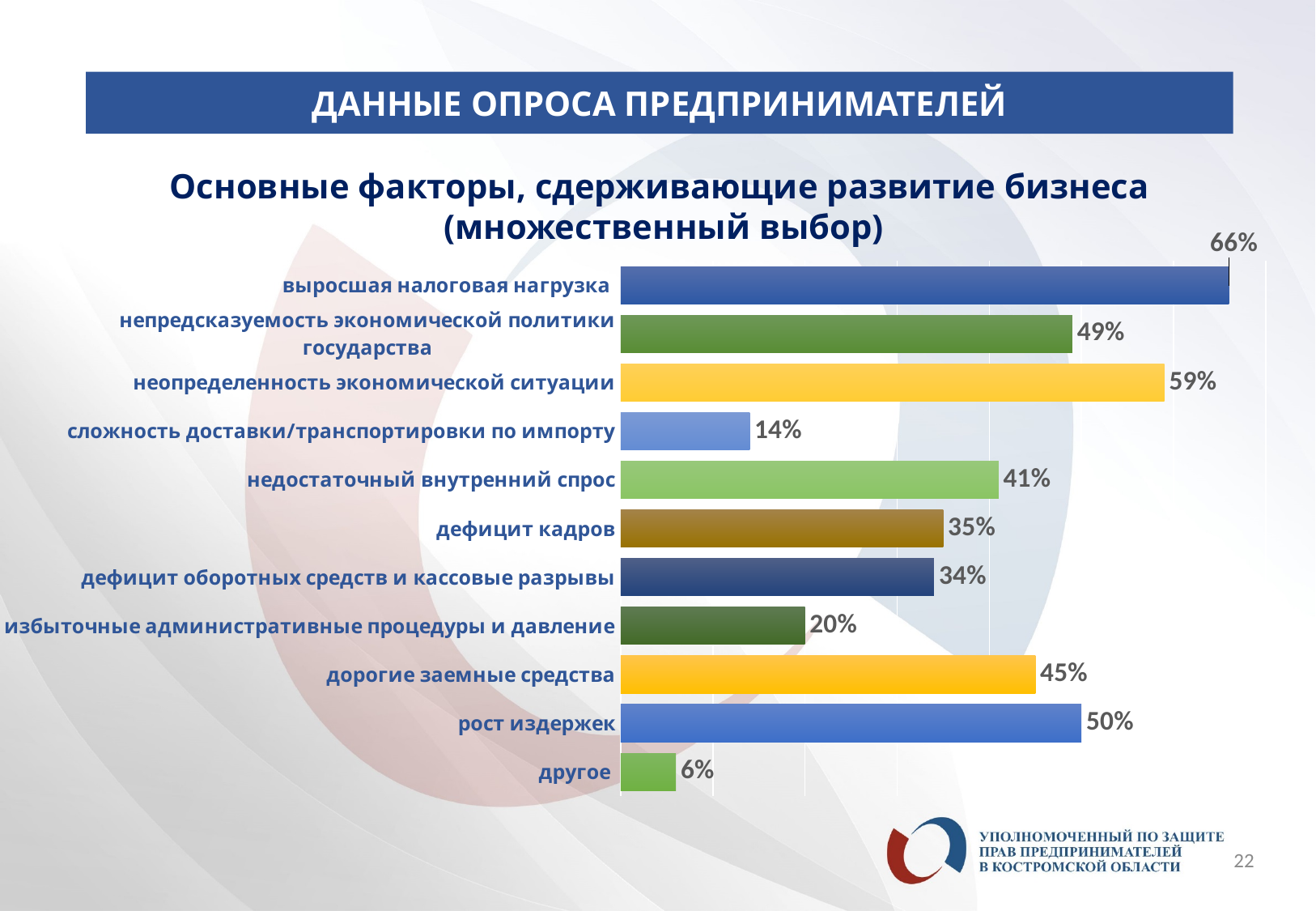
What is the value for «выросшая налоговая нагрузка»? 66% What is the difference between «неопределенность экономической ситуации» and «непредсказуемость экономической политики государства»? 10% Which is larger: «сложность доставки/транспортировки по импорту» or «избыточные административные процедуры и давление»? избыточные административные процедуры и давление What is the title of the chart? Основные факторы, сдерживающие развитие бизнеса (множественный выбор) How many categories are shown in the chart? 11 What is the value for «дорогие заемные средства»? 45% What kind of chart is shown on the slide? bar chart What is the difference between «дефицит кадров» and «дефицит оборотных средств и кассовые разрывы»? 1% Which category has the lowest value? другое What is the value for «дефицит кадров»? 35% Which is larger: «рост издержек» or «недостаточный внутренний спрос»? рост издержек Which category has the highest value? выросшая налоговая нагрузка